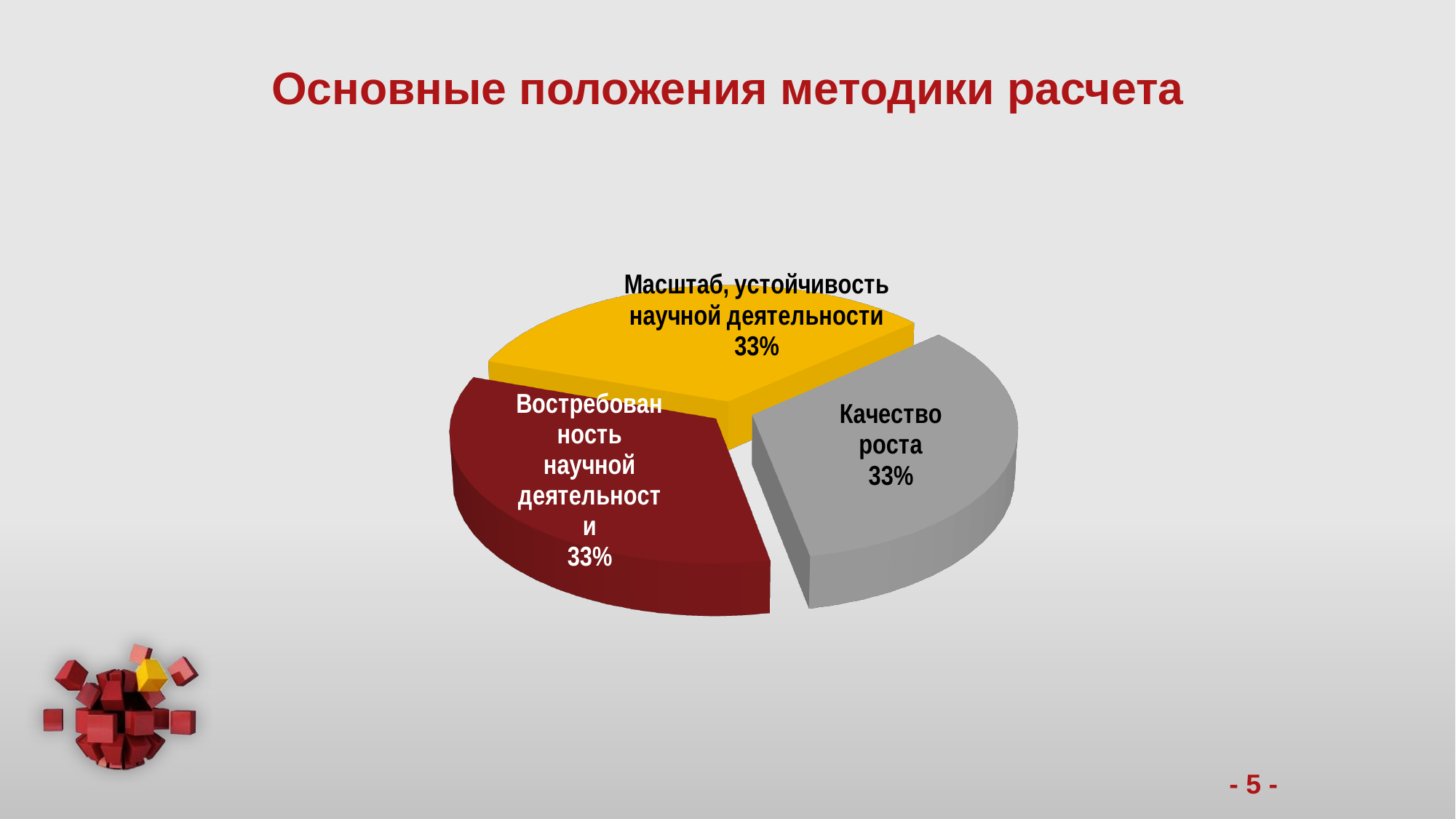
What kind of chart is shown on the slide? pie chart What value is printed on the "Качество роста" slice? 33% What share of the pie does the slice "Масштаб, устойчивость научной деятельности" represent? 33% What share of the pie does the slice "Качество роста" represent? 33% What share of the pie does the slice "Востребованность научной деятельности" represent? 33% What is the difference between the values of the "Качество роста" slice and the "Востребованность научной деятельности" slice? 0% How many slices does the pie chart have? 3 What colour is the "Качество роста" slice? grey Are the values of the slices "Качество роста" and "Масштаб, устойчивость научной деятельности" equal? yes What colour is the "Масштаб, устойчивость научной деятельности" slice? yellow